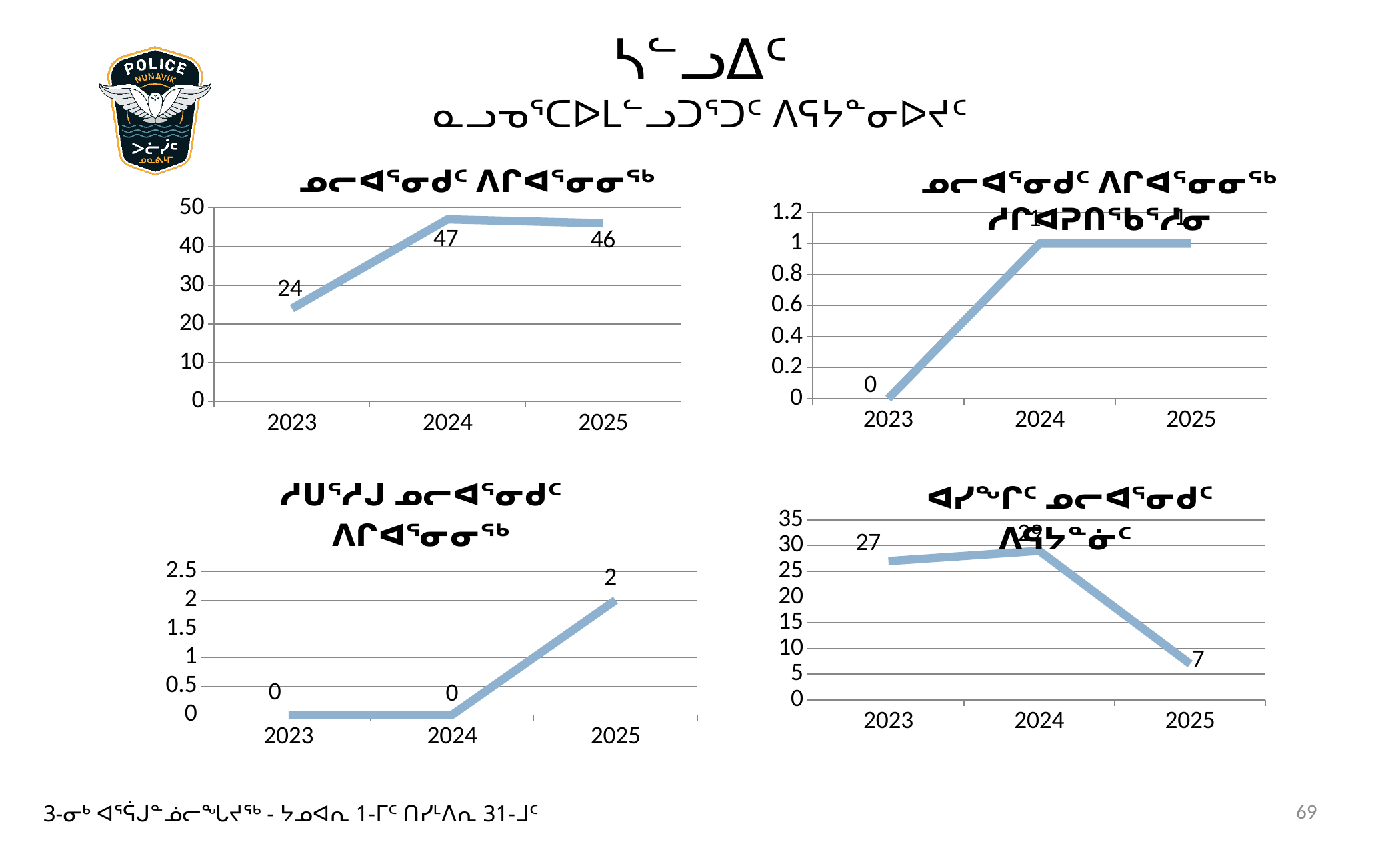
In the bottom-left chart, what is the value for 2025? 2 In the bottom-right chart, is the value for 2023 greater or less than 25? greater In the top-right chart, what is the value for 2025? 1 In the top-left chart, what is the difference between the 2024 and 2023 values? 23 In the bottom-left chart, which year has the highest value? 2025 In the top-left chart, which year has the highest value? 2024 In the top-left chart, what is the value for 2023? 24 In the bottom-right chart, which year has the lowest value? 2025 What kind of chart is the bottom-left chart? line chart In the top-right chart, what is the value for 2023? 0 In the top-left chart, what is the value for 2024? 47 In the bottom-right chart, what is the value for 2025? 7